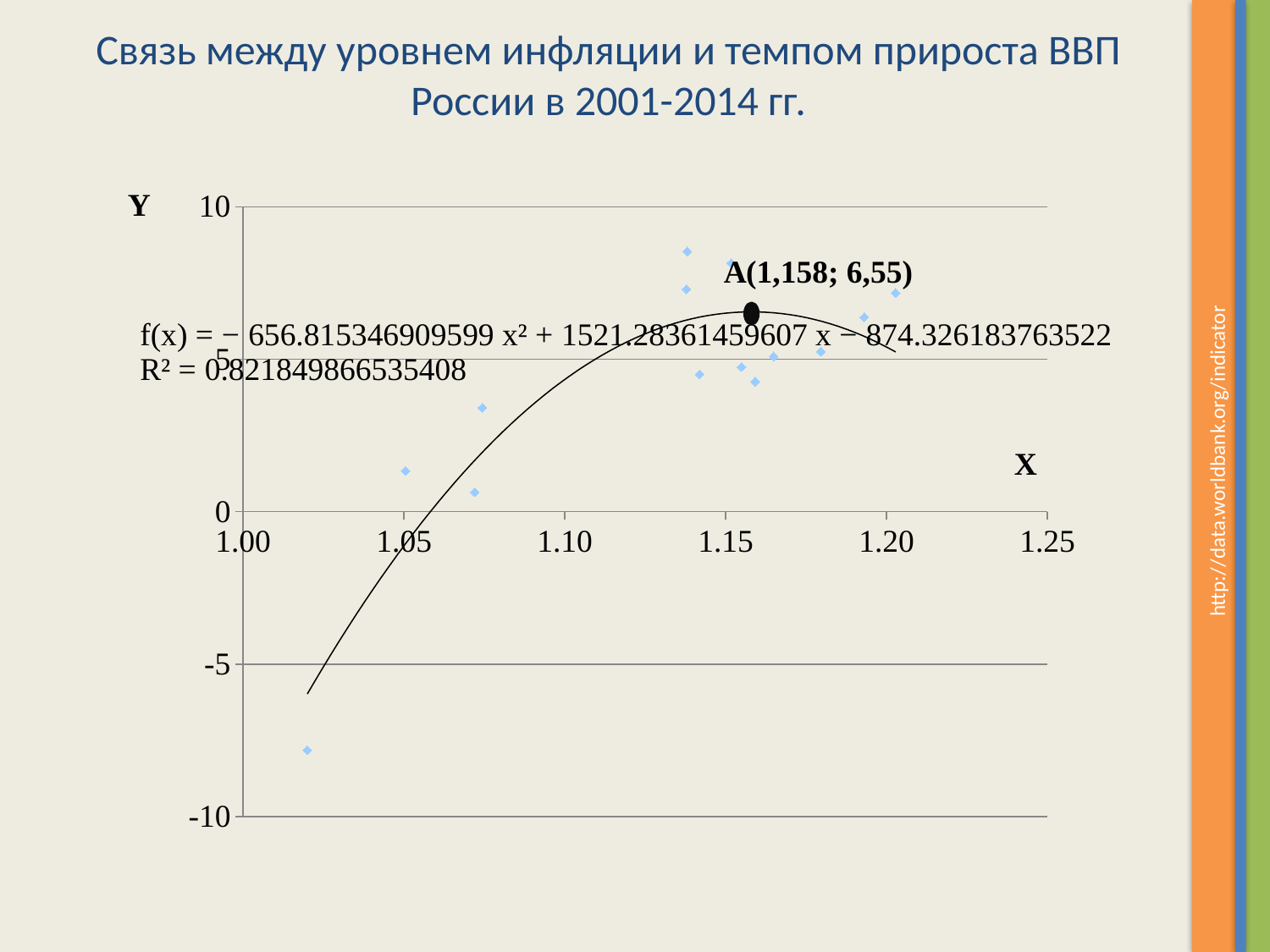
What is the title of the chart? Связь между уровнем инфляции и темпом прироста ВВП России в 2001-2014 гг. What is the R² value printed on the chart? 0.821849866535408 What is the coefficient of x² in the fitted function f(x) shown on the chart? −656.815346909599 What are the coordinates of point A marked on the fitted curve? (1,158; 6,55) Is the Y value of the highest plotted point greater or less than 10? less What kind of chart is shown on the slide? Scatter chart Is the Y value of the highest plotted point greater or less than 5? greater What is the constant term in the fitted function f(x) shown on the chart? −874.326183763522 Is the Y value of the lowest plotted point greater or less than -5? less What is the maximum value shown on the X axis? 1.25 Which plotted point has the lower Y value: the one near X = 1.02 or the one near X = 1.20? The one near X = 1.02 Does the fitted curve rise or fall as X increases from 1.00 to 1.15? rise